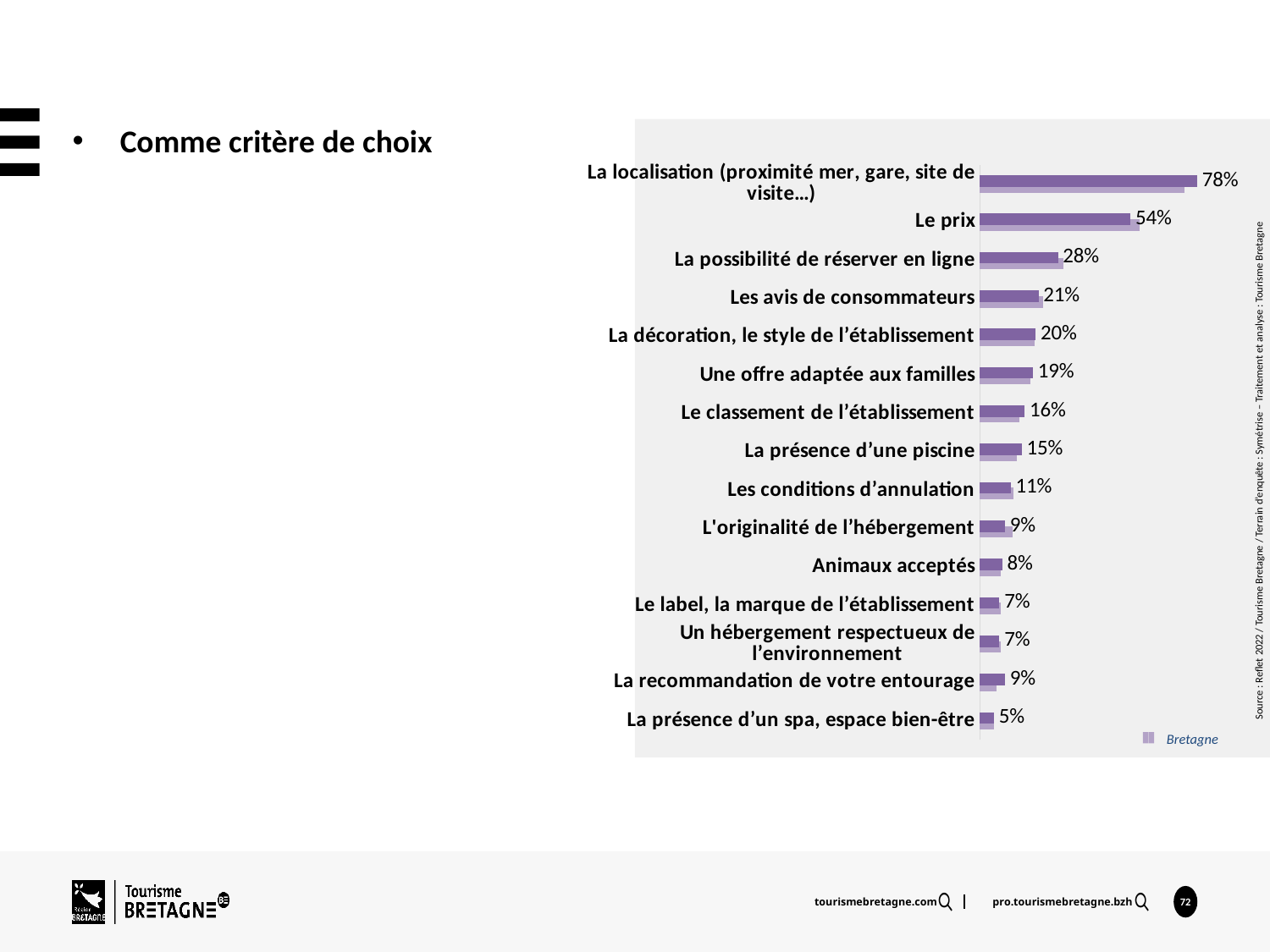
Which is larger, the value for "Les avis de consommateurs" or the value for "Le classement de l'établissement"? Les avis de consommateurs How many categories are shown in the chart? 15 How many series does the legend list? 1 What is the value for "Animaux acceptés"? 8% What is the value for "La présence d'une piscine"? 15% What is the name of the series shown in the legend? Bretagne What kind of chart is shown on the slide? Bar chart What is the value for "Le prix"? 54% Which category has the lowest value? La présence d'un spa, espace bien-être Which category has the highest value? La localisation (proximité mer, gare, site de visite…) What is the difference between the values for "La localisation (proximité mer, gare, site de visite…)" and "Le prix"? 24% What is the value for "La possibilité de réserver en ligne"? 28%